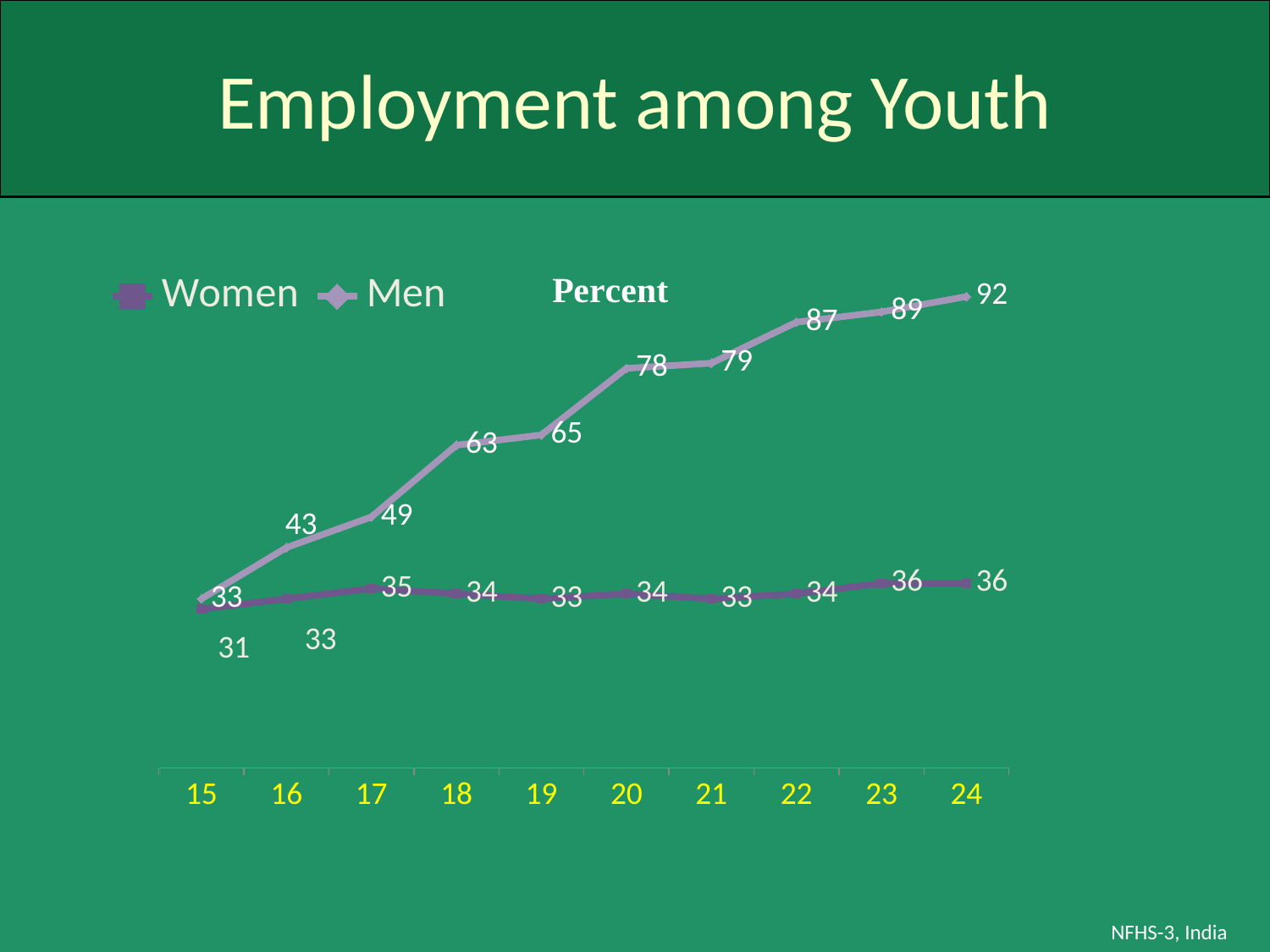
What is the employment percentage for Men at age 24? 92 Which series has the higher value at age 20, Women or Men? Men What is the employment percentage for Women at age 15? 31 At which age is the value for Men the highest? 24 Does the Men series generally rise or fall as age increases from 15 to 24? Rise What is the title of the chart on the slide? Employment among Youth What is the difference between the Men and Women values at age 24? 56 What is the employment percentage for Men at age 18? 63 At which age is the value for Men the lowest? 15 How many age categories are shown on the x axis? 10 How many series does the legend list? 2 What type of chart is shown on the slide? Line chart